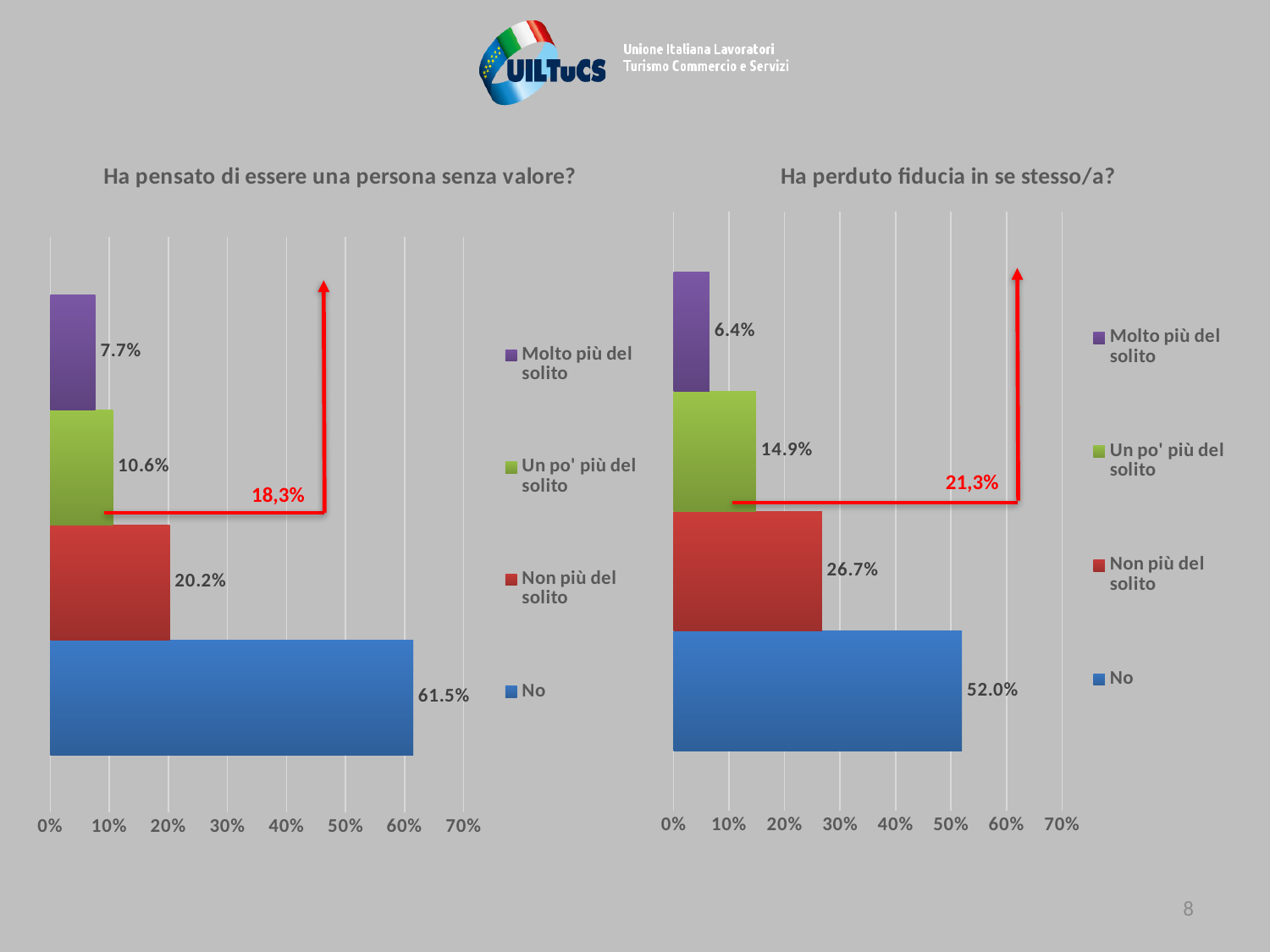
In the chart 'Ha pensato di essere una persona senza valore?', what is the difference between the values for 'No' and 'Non più del solito'? 41.3% In the chart 'Ha pensato di essere una persona senza valore?', what is the value for 'Un po' più del solito'? 10.6% How many series does the legend of the chart 'Ha perduto fiducia in se stesso/a?' list? 4 What kind of chart is 'Ha pensato di essere una persona senza valore?'? Bar chart In the chart 'Ha perduto fiducia in se stesso/a?', what is the difference between the values for 'Un po' più del solito' and 'Molto più del solito'? 8.5% Which is larger: the value for 'No' in the chart 'Ha pensato di essere una persona senza valore?' or the value for 'No' in the chart 'Ha perduto fiducia in se stesso/a?'? Ha pensato di essere una persona senza valore? In the chart 'Ha perduto fiducia in se stesso/a?', what value does the red annotation show? 21,3% In the chart 'Ha perduto fiducia in se stesso/a?', which category has the lowest value? Molto più del solito In the chart 'Ha pensato di essere una persona senza valore?', which category has the highest value? No In the chart 'Ha pensato di essere una persona senza valore?', what is the value for 'No'? 61.5% In the chart 'Ha perduto fiducia in se stesso/a?', what is the value for 'Non più del solito'? 26.7% In the chart 'Ha perduto fiducia in se stesso/a?', what is the value for 'Molto più del solito'? 6.4%